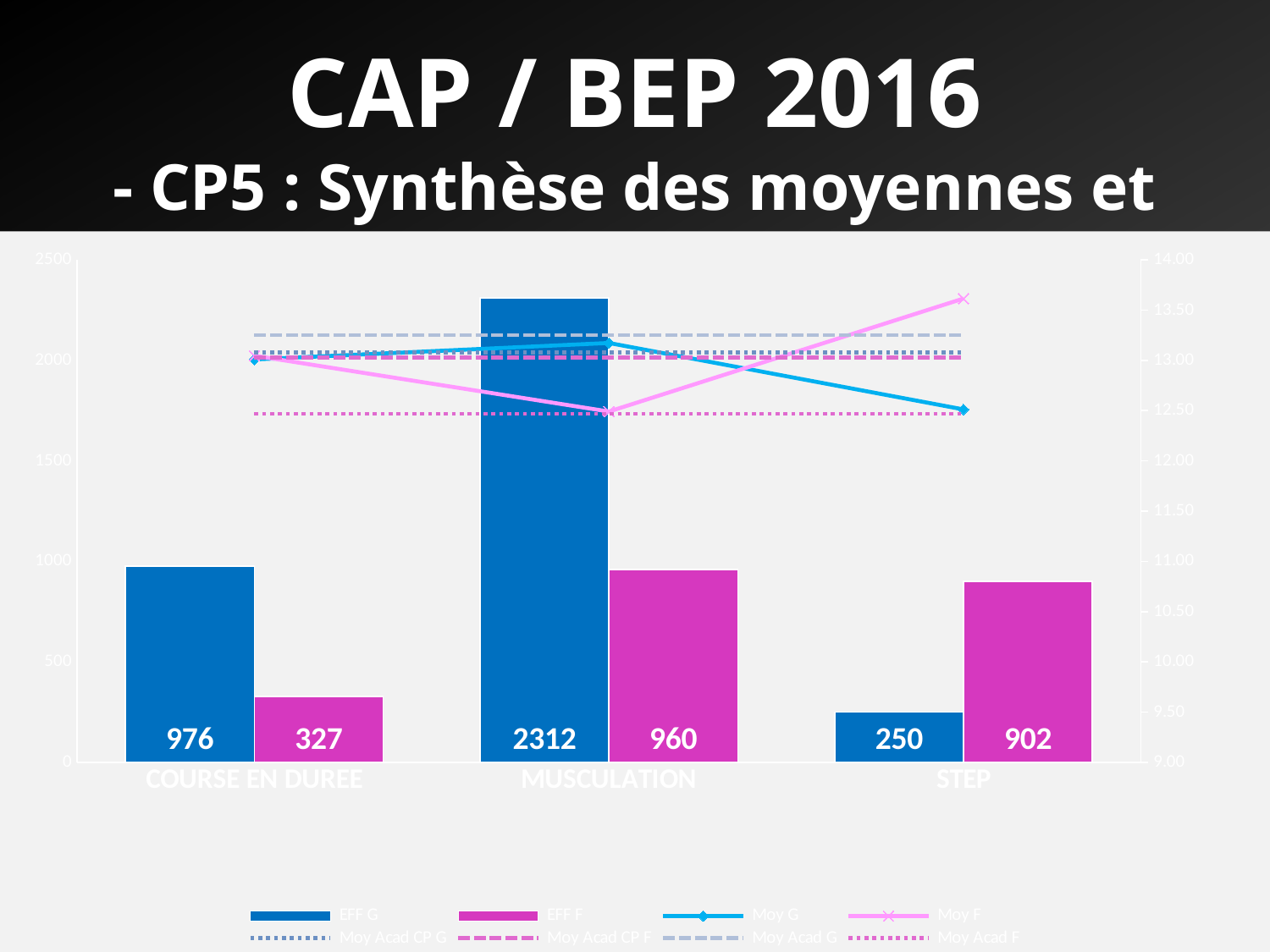
Is the value of the pink Moy F line at STEP greater or less than 13.00 on the right axis? greater What is the value of the blue EFF G bar for MUSCULATION? 2312 What is the value of the magenta EFF F bar for STEP? 902 What is the value of the blue EFF G bar for COURSE EN DUREE? 976 Which category has the highest blue EFF G bar? MUSCULATION Which category has the lowest blue EFF G bar? STEP What is the difference between the blue and magenta bars for MUSCULATION? 1352 What kind of chart is shown on the slide? a bar chart combined with line series For STEP, which bar is larger, the blue EFF G bar or the magenta EFF F bar? the magenta EFF F bar What is the difference between the magenta and blue bars for STEP? 652 What is the value of the magenta EFF F bar for COURSE EN DUREE? 327 How many categories are shown on the x axis? 3